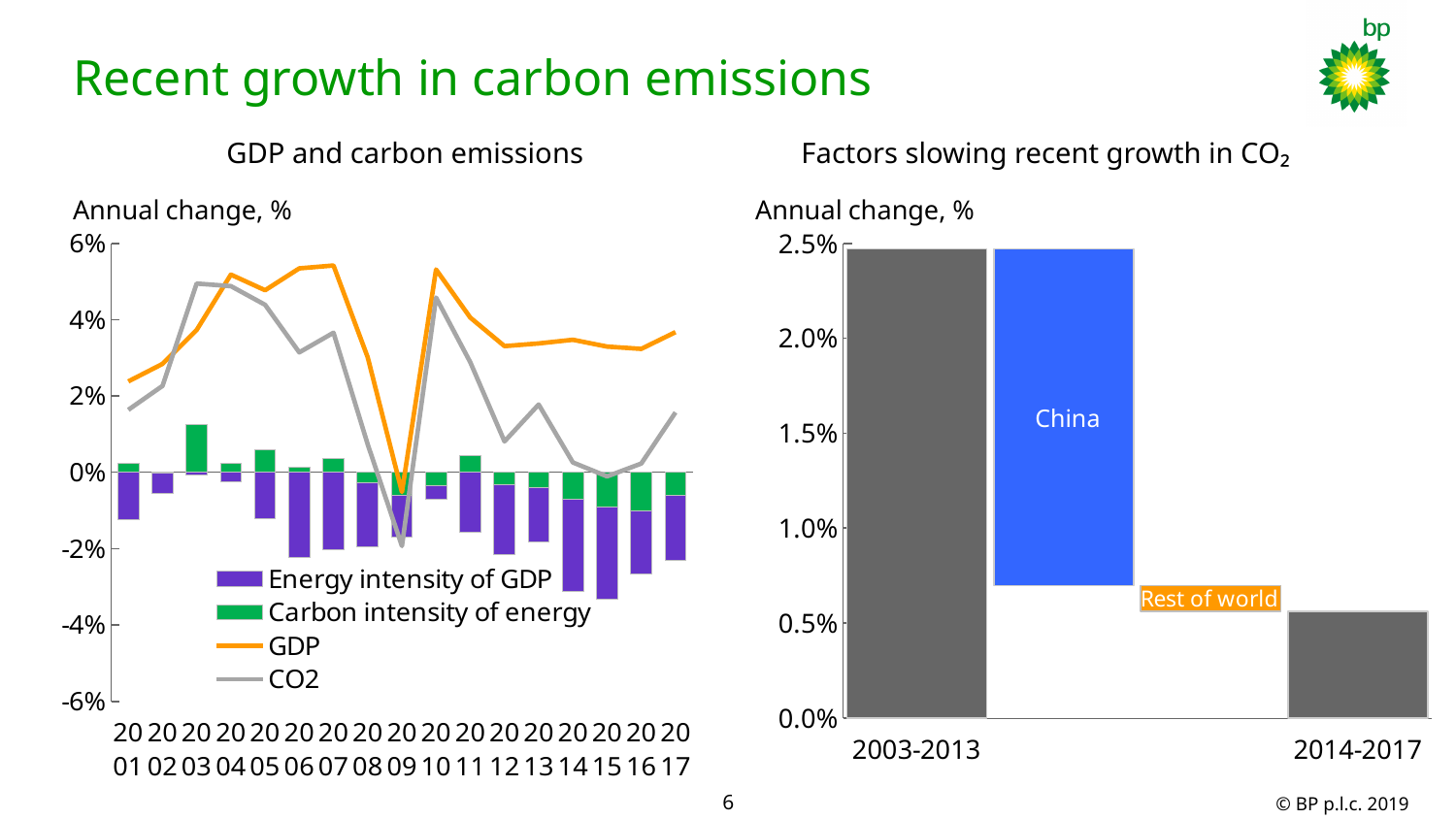
On the left chart 'GDP and carbon emissions', how many years are shown on the x axis? 17 On the right chart 'Factors slowing recent growth in CO₂', what kind of chart is shown? Bar chart On the right chart 'Factors slowing recent growth in CO₂', what does the blue segment represent? China On the right chart 'Factors slowing recent growth in CO₂', is the value for 2014-2017 greater or less than 1.0%? less On the left chart 'GDP and carbon emissions', how many series does the legend list? 4 On the left chart 'GDP and carbon emissions', does the CO2 line rise or fall from 2010 to 2015? fall On the left chart 'GDP and carbon emissions', in which year is the GDP line at its lowest? 2009 On the left chart 'GDP and carbon emissions', which is larger in 2017, the GDP value or the CO2 value? GDP On the left chart 'GDP and carbon emissions', is the Energy intensity of GDP value for 2015 greater or less than -2%? less On the left chart 'GDP and carbon emissions', is the CO2 value for 2009 greater or less than 0%? less